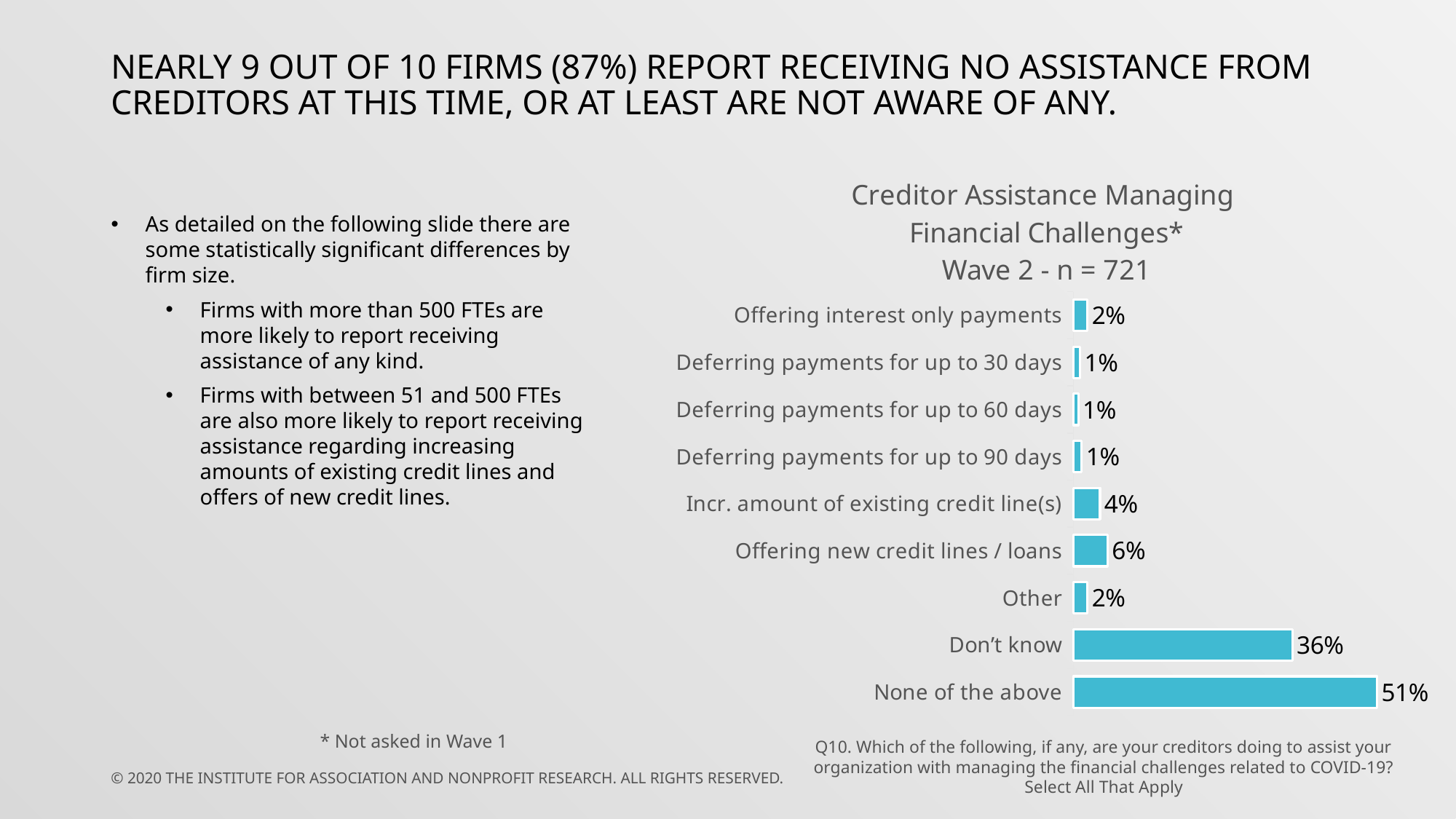
What is the value for 'Deferring payments for up to 30 days'? 1% What is the difference between 'Offering new credit lines / loans' and 'Offering interest only payments'? 4% What is the value for 'Don't know'? 36% What percentage of firms report creditors offering new credit lines / loans? 6% What is the sample size (n) stated in the chart title? 721 Which category has the highest value in the chart? None of the above How many categories are shown in the chart? 9 What percentage of firms report 'None of the above' for creditor assistance? 51% What is the value for 'Incr. amount of existing credit line(s)'? 4% Which is larger: 'Offering new credit lines / loans' or 'Incr. amount of existing credit line(s)'? Offering new credit lines / loans What kind of chart is shown on the slide? Bar chart What is the difference between 'None of the above' and 'Don't know'? 15%